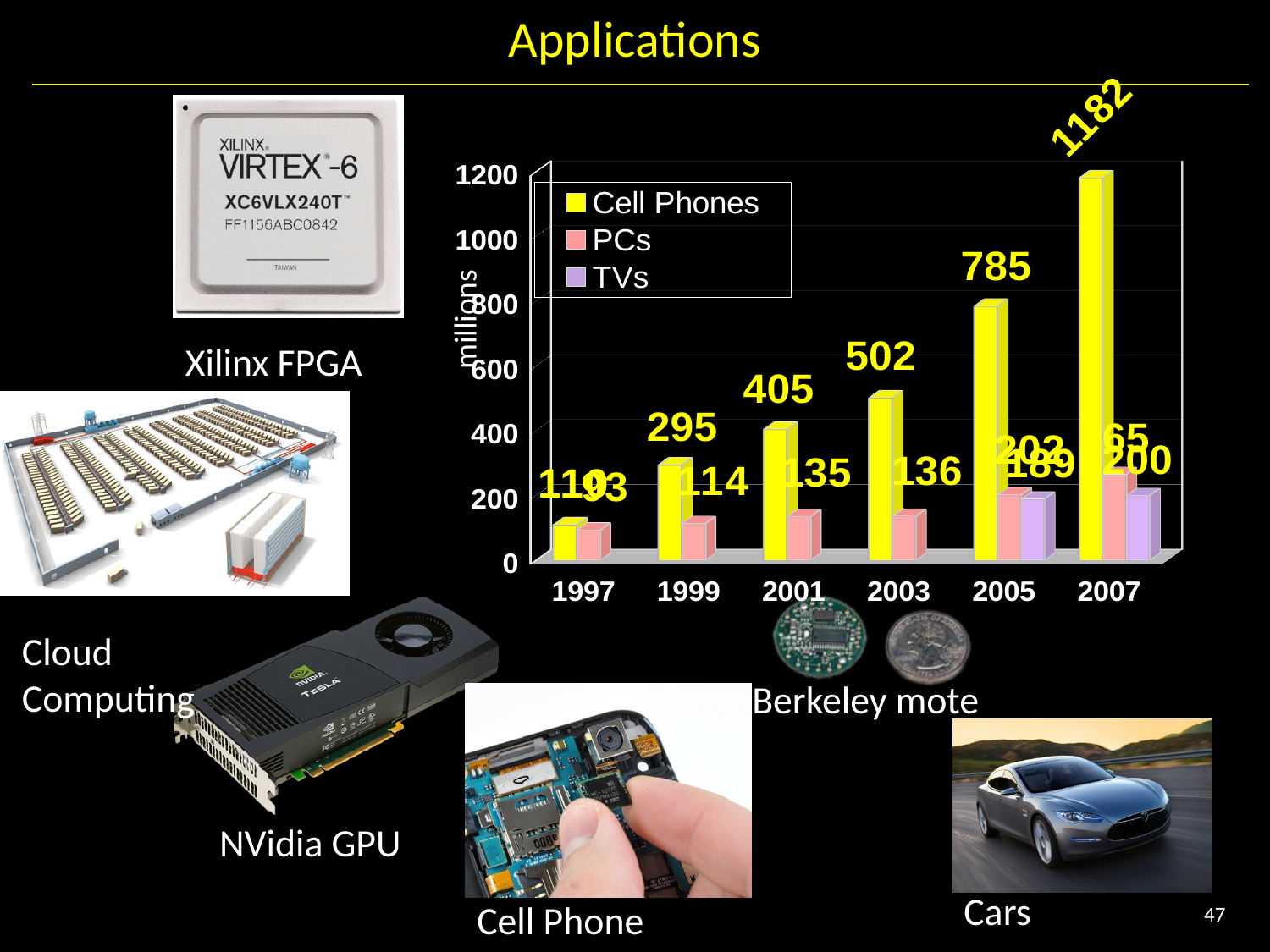
What is the value for Cell Phones in 2005? 785 What is the value for Cell Phones in 2007? 1182 In which year is the Cell Phones value highest? 2007 What is the value for PCs in 2003? 136 What is the difference between the Cell Phones values for 2007 and 2005? 397 How many series does the legend list? 3 Which is larger in 2005, the Cell Phones value or the PCs value? Cell Phones Do the Cell Phones values rise or fall from 1997 to 2007? rise How many years are shown on the x axis? 6 What is the value for PCs in 2001? 135 Is the value for TVs in 2007 greater or less than 400? less What is the difference between the Cell Phones values for 2003 and 2001? 97